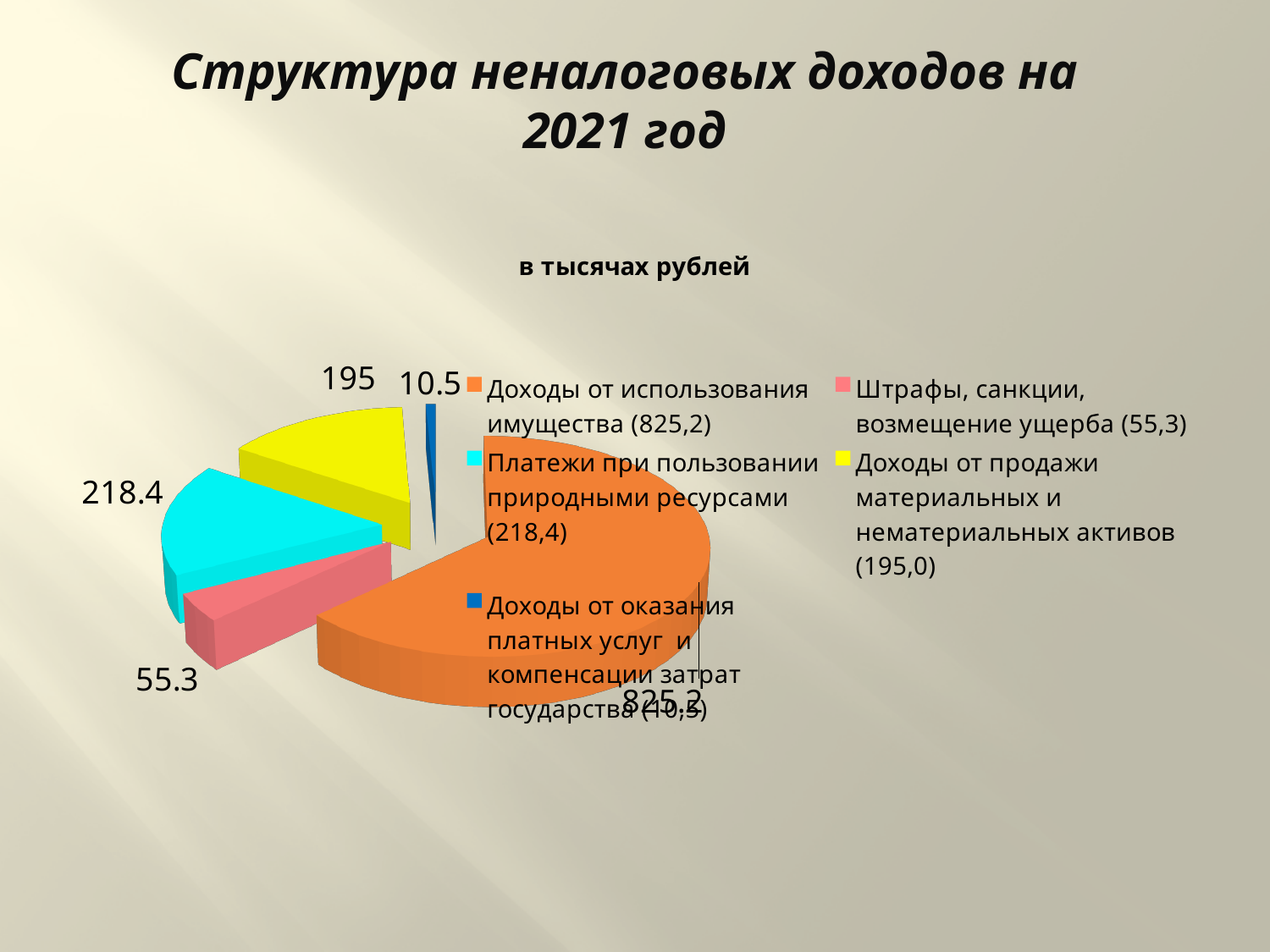
What unit of measurement is stated above the chart? в тысячах рублей What is the difference between the values for "Доходы от использования имущества" and "Платежи при пользовании природными ресурсами"? 606.8 How many slices does the pie chart have? 5 What is the value of the slice for "Штрафы, санкции, возмещение ущерба"? 55.3 What colour is the slice for "Штрафы, санкции, возмещение ущерба"? Pink What is the value of the slice for "Доходы от продажи материальных и нематериальных активов"? 195 What is the value of the slice for "Платежи при пользовании природными ресурсами"? 218.4 What is the value of the slice for "Доходы от использования имущества"? 825.2 What kind of chart is shown on the slide? Pie chart Which category has the largest slice of the pie? Доходы от использования имущества Which is larger: the slice for "Платежи при пользовании природными ресурсами" or the slice for "Доходы от продажи материальных и нематериальных активов"? Платежи при пользовании природными ресурсами Which category has the smallest slice of the pie? Доходы от оказания платных услуг и компенсации затрат государства